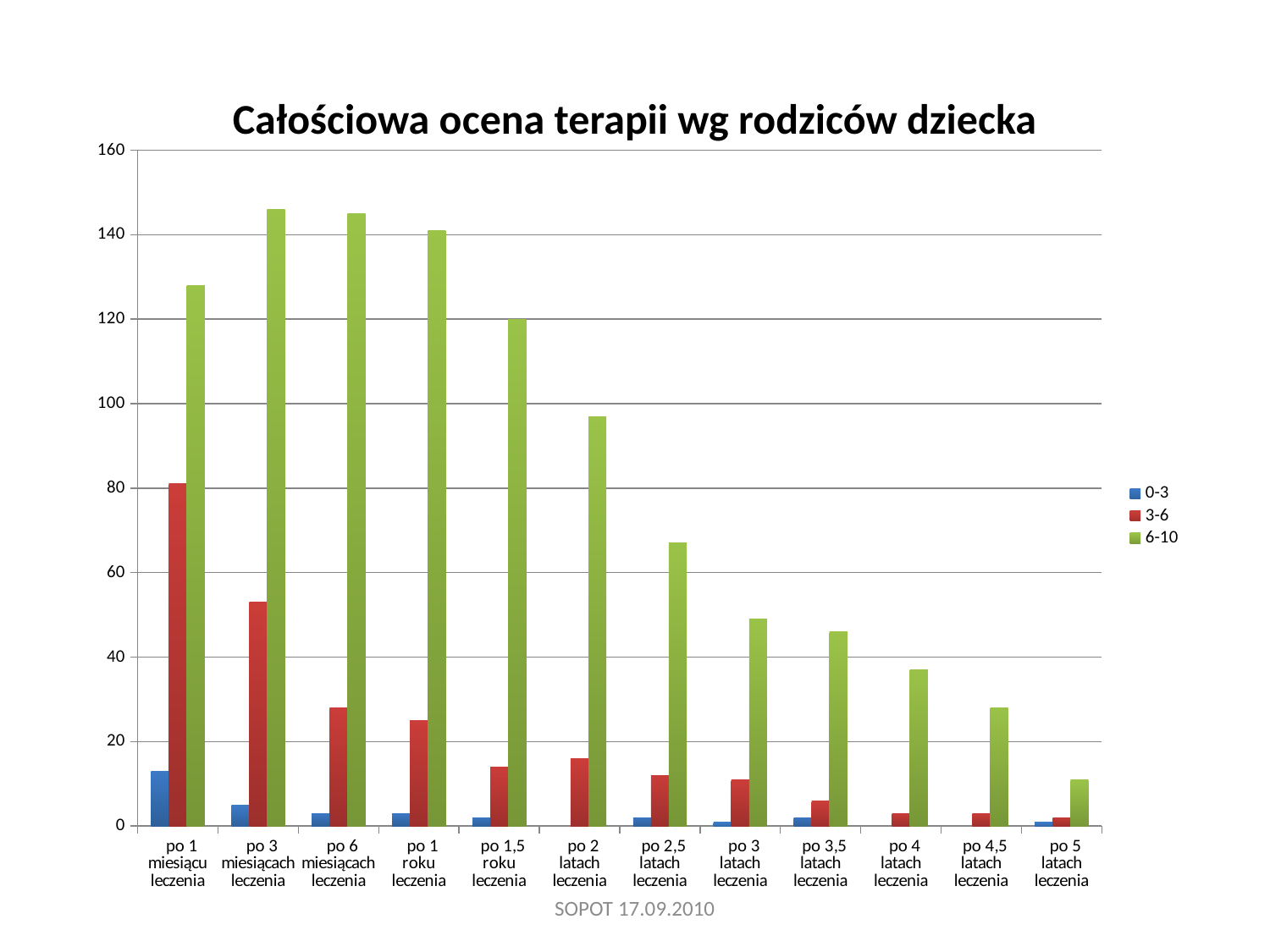
From po 3 miesiącach leczenia to po 5 latach leczenia, do the 6-10 values rise or fall? fall Is the 6-10 value for po 4,5 latach leczenia greater or less than 40? less Is the 6-10 value for po 1 miesiącu leczenia greater or less than 120? greater How many categories are shown along the x axis? 12 What kind of chart is shown on the slide? bar chart Which category has the highest value for the 3-6 series? po 1 miesiącu leczenia Which is larger for the 6-10 series: po 2,5 latach leczenia or po 3 latach leczenia? po 2,5 latach leczenia How many series does the legend list? 3 Is the 6-10 value for po 2 latach leczenia greater or less than 80? greater Which category has the lowest value for the 6-10 series? po 5 latach leczenia What are the three entries in the legend? 0-3, 3-6, 6-10